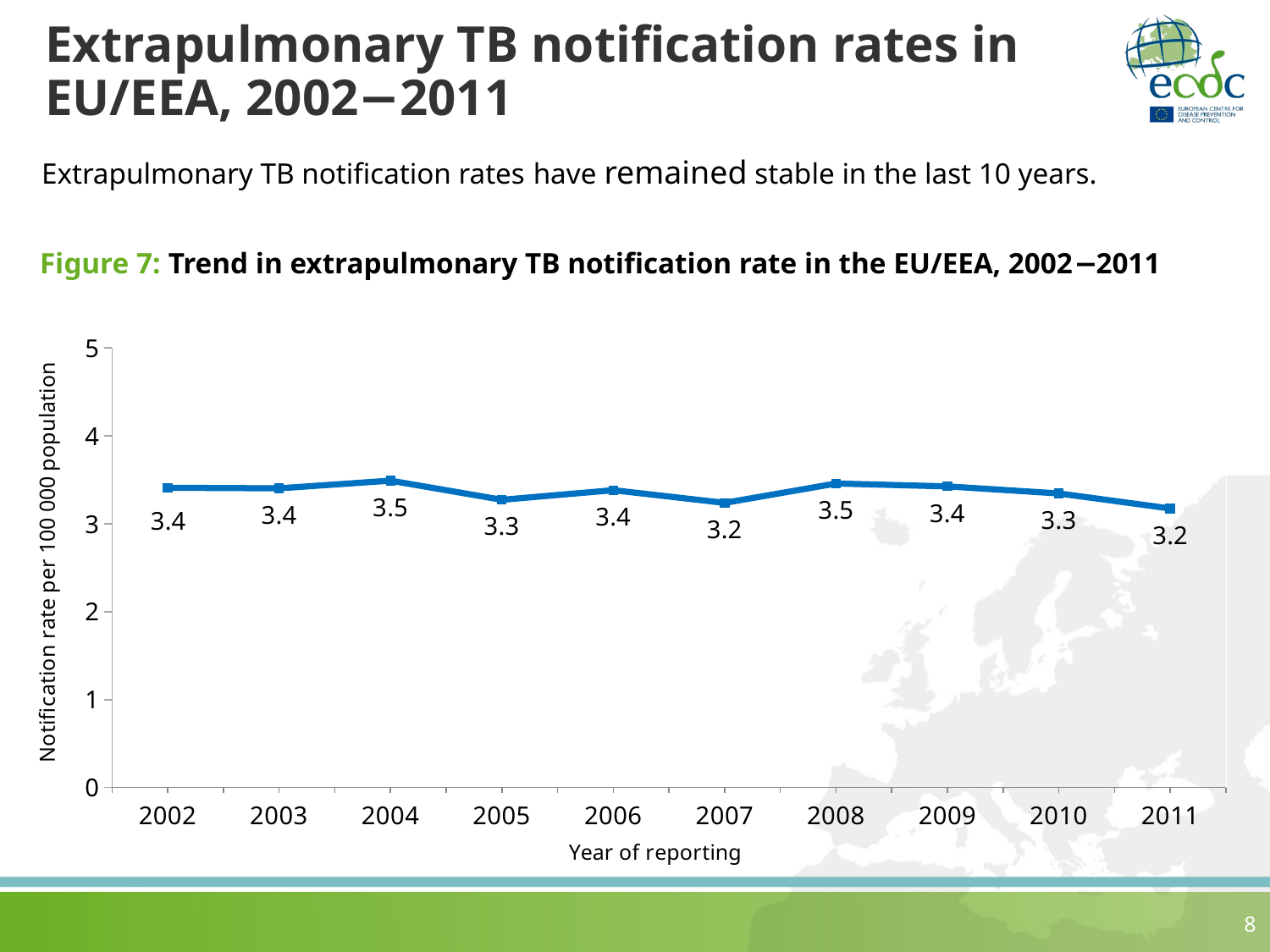
What was the notification rate in 2011? 3.2 What is the difference between the notification rate in 2008 and in 2011? 0.3 What is the highest notification rate shown on the chart? 3.5 Is the notification rate for 2009 greater or less than 4? less How many years of reporting are plotted on the chart? 10 What was the notification rate in 2002? 3.4 What was the extrapulmonary TB notification rate per 100 000 population in 2004? 3.5 What is the label of the y axis? Notification rate per 100 000 population What kind of chart is shown on the slide? Line chart What was the notification rate in 2007? 3.2 Which year had a higher notification rate, 2004 or 2005? 2004 What is the lowest notification rate shown on the chart? 3.2